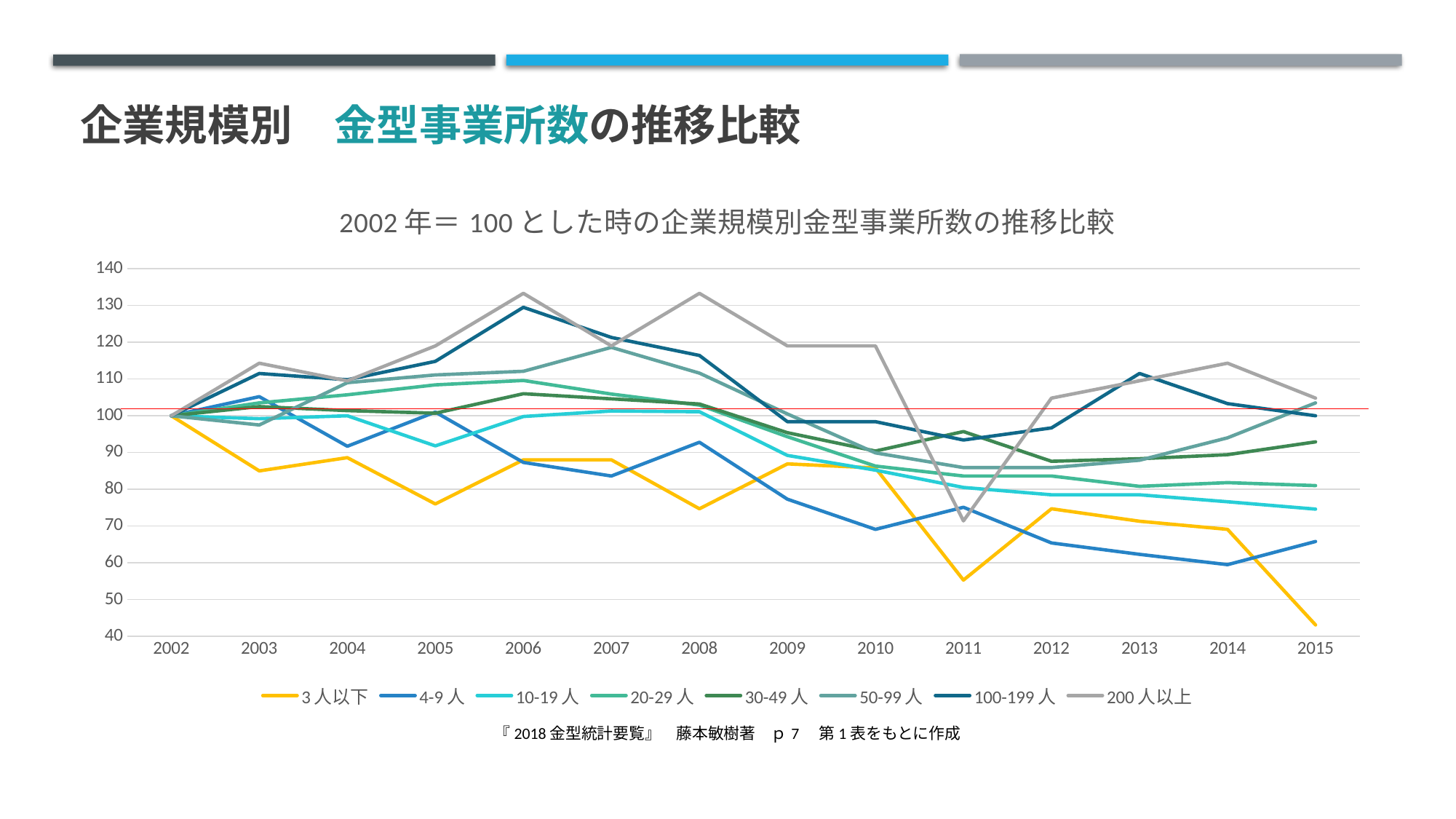
Which series has the lowest value in 2015? 3人以下 What is the title of the chart? 2002年＝100とした時の企業規模別金型事業所数の推移比較 How many years are plotted along the x axis? 14 How many series does the legend list? 8 In 2011, which is larger: the value for 3人以下 or the value for 4-9人? 4-9人 Does the value for 3人以下 rise or fall overall from 2002 to 2015? fall Is the value for 3人以下 in 2015 greater or less than 50? less What is the value for 3人以下 in 2002? 100 Is the value for 200人以上 in 2006 greater or less than 130? greater Is the value for 4-9人 in 2014 greater or less than 70? less What kind of chart is shown on the slide? line chart Which series has the highest value in 2006? 200人以上